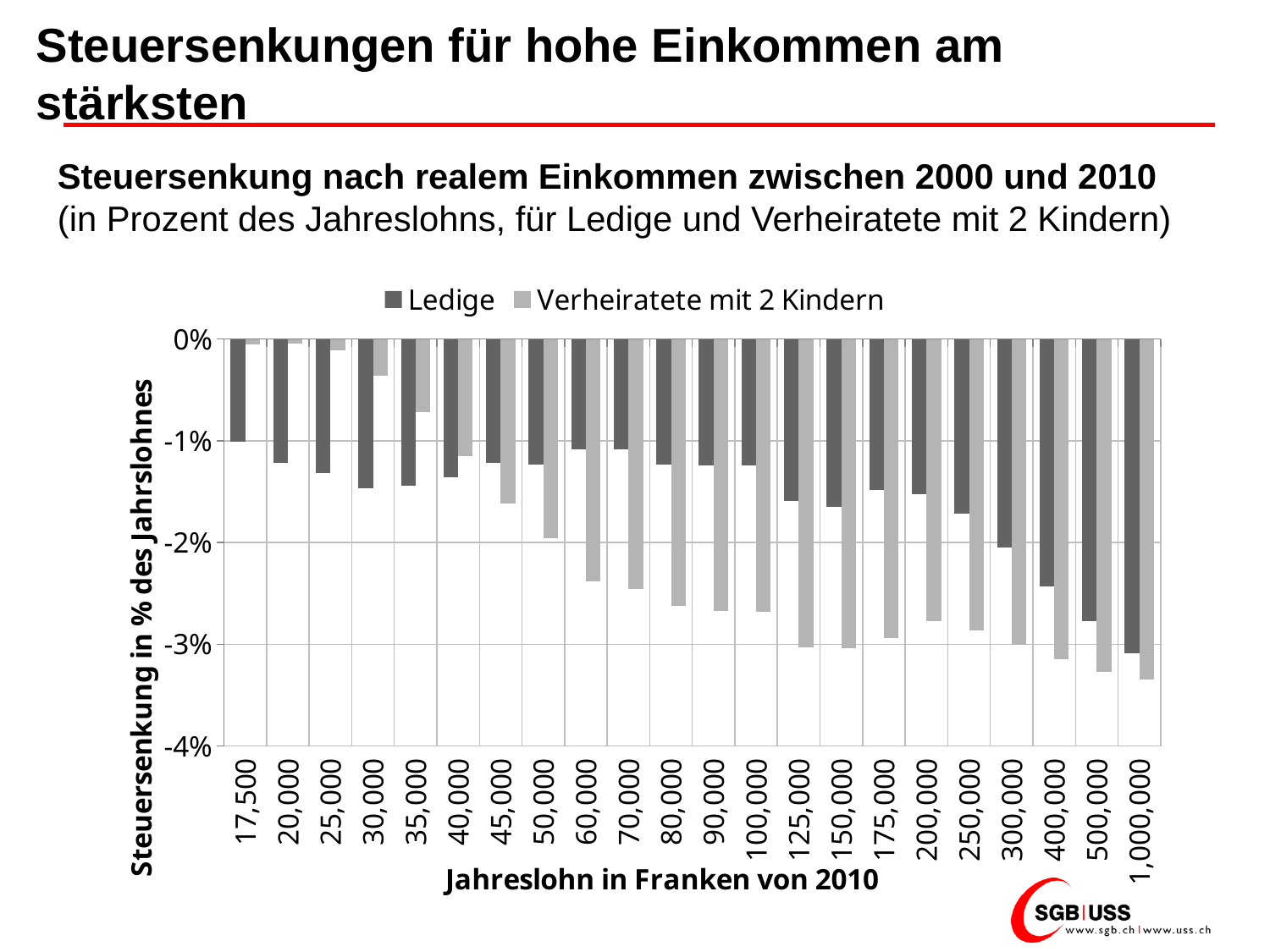
Is the value for Ledige at 60,000 greater or less than -2%? greater Is the value for Ledige at 400,000 greater or less than -2%? less How many income categories are shown on the x axis? 22 What is the title of the y axis? Steuersenkung in % des Jahrslohnes What are the two series named in the legend? Ledige; Verheiratete mit 2 Kindern Is the value for Verheiratete mit 2 Kindern at 1,000,000 greater or less than -3%? less For which income category is the tax reduction for Verheiratete mit 2 Kindern the largest (most negative)? 1,000,000 At an income of 100,000, which series shows the larger tax reduction, Ledige or Verheiratete mit 2 Kindern? Verheiratete mit 2 Kindern What kind of chart is shown on the slide? bar chart For which income category is the tax reduction for Ledige the largest (most negative)? 1,000,000 How many series does the legend list? 2